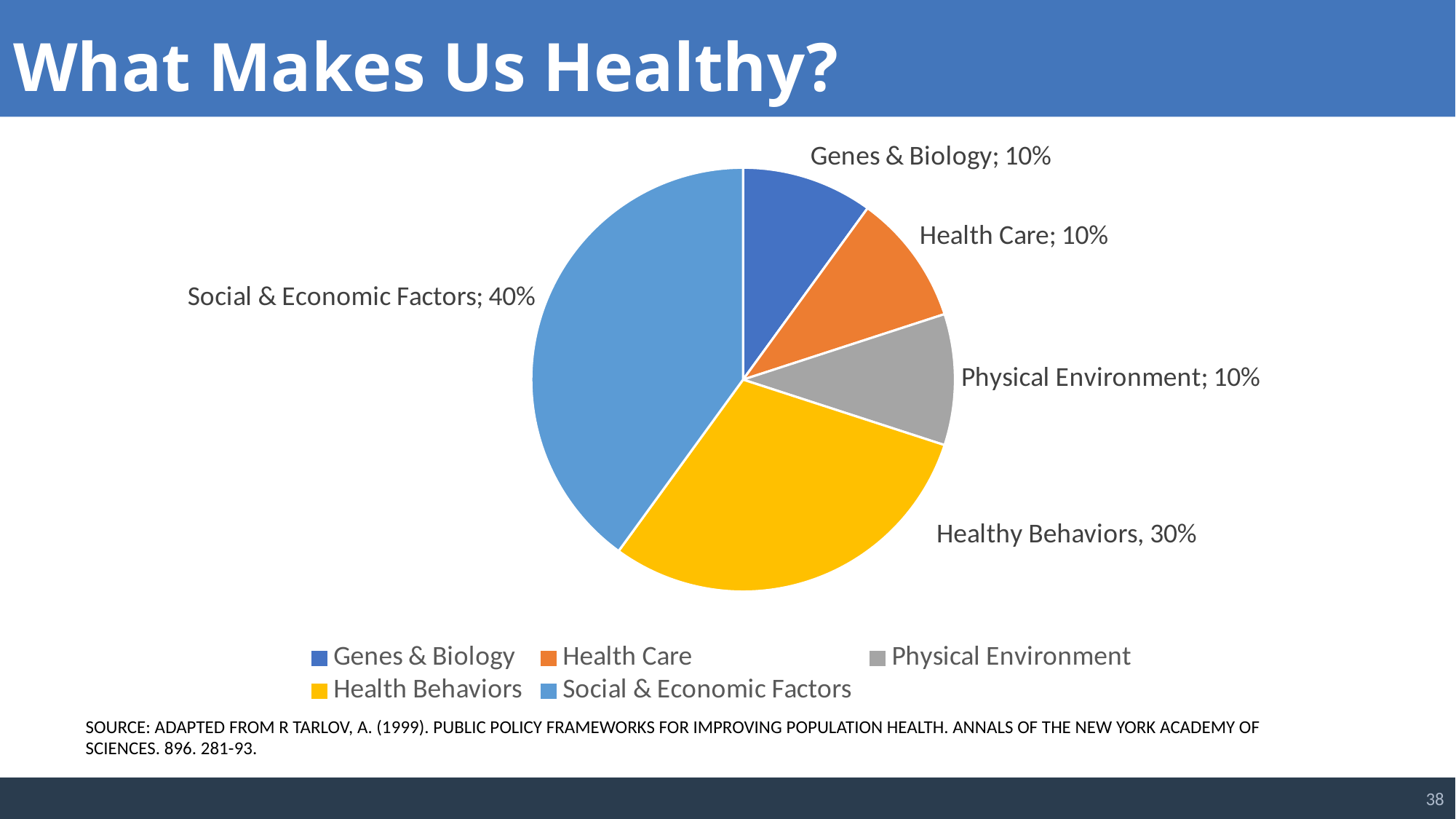
What is the difference between the Social & Economic Factors share and the Healthy Behaviors share? 10% What share of the pie is Social & Economic Factors? 40% What is the value shown for Healthy Behaviors? 30% What is the value shown for Health Care? 10% Which is larger, Healthy Behaviors or Genes & Biology? Healthy Behaviors Which category has the largest slice of the pie? Social & Economic Factors What colour is the Healthy Behaviors slice? yellow What kind of chart is shown on the slide? pie chart How many categories does the legend list? 5 How many slices does the pie chart have? 5 What is the title of the slide containing the pie chart? What Makes Us Healthy? What is the value shown for Physical Environment? 10%